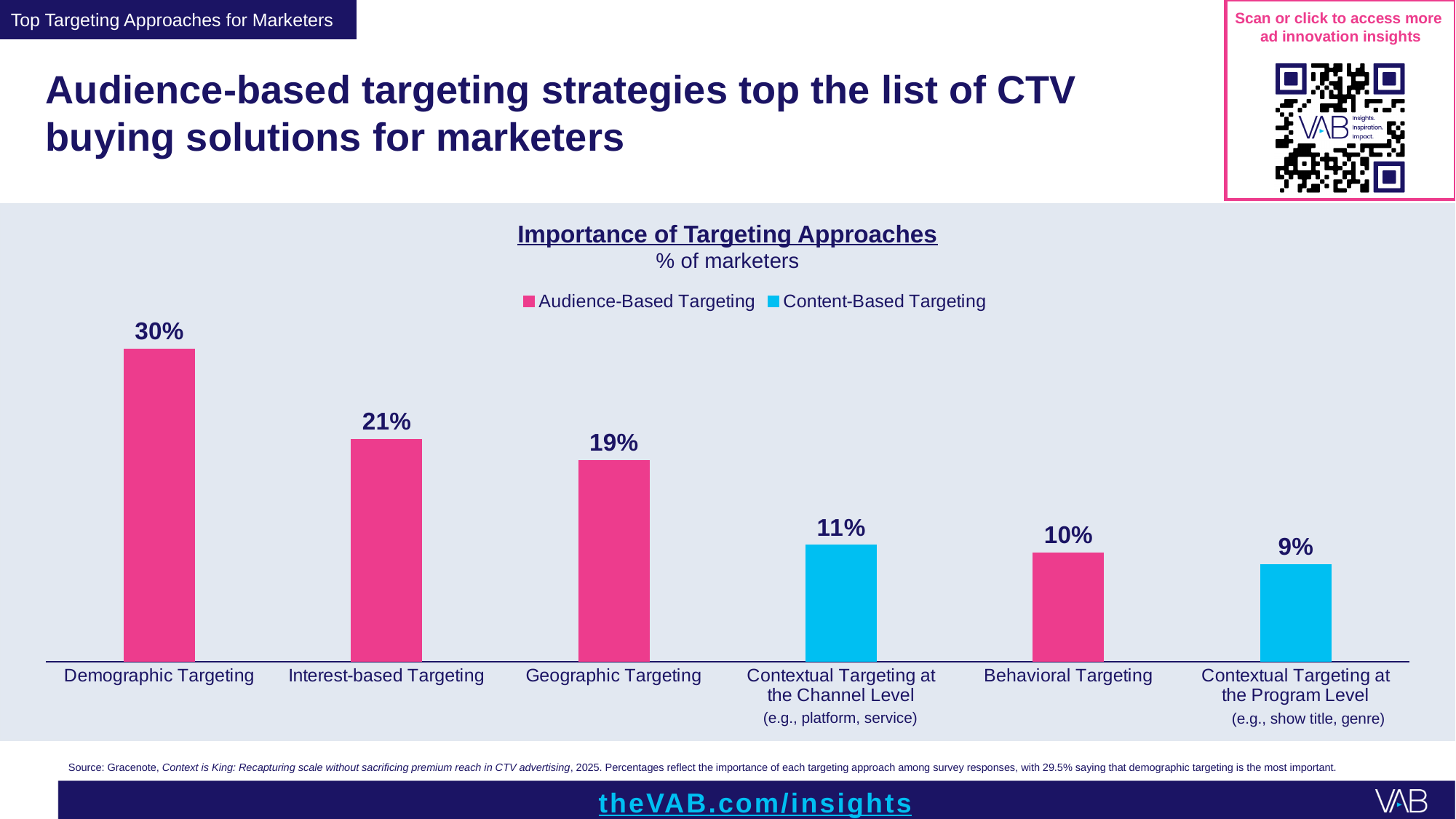
Which series does the Contextual Targeting at the Program Level bar belong to, according to the legend colours? Content-Based Targeting What value is shown for Behavioral Targeting? 10% What is the difference between the values for Demographic Targeting and Interest-based Targeting? 9% Do the values rise or fall from left to right across the chart? Fall Which targeting approach has the lowest percentage of marketers? Contextual Targeting at the Program Level What value is shown for Contextual Targeting at the Channel Level? 11% How many series does the legend list? 2 What kind of chart is shown on the slide? Bar chart How many targeting approaches are shown on the chart? 6 Which targeting approach has the highest percentage of marketers? Demographic Targeting What percentage of marketers is shown for Demographic Targeting? 30% Which is larger, the value for Geographic Targeting or the value for Interest-based Targeting? Interest-based Targeting